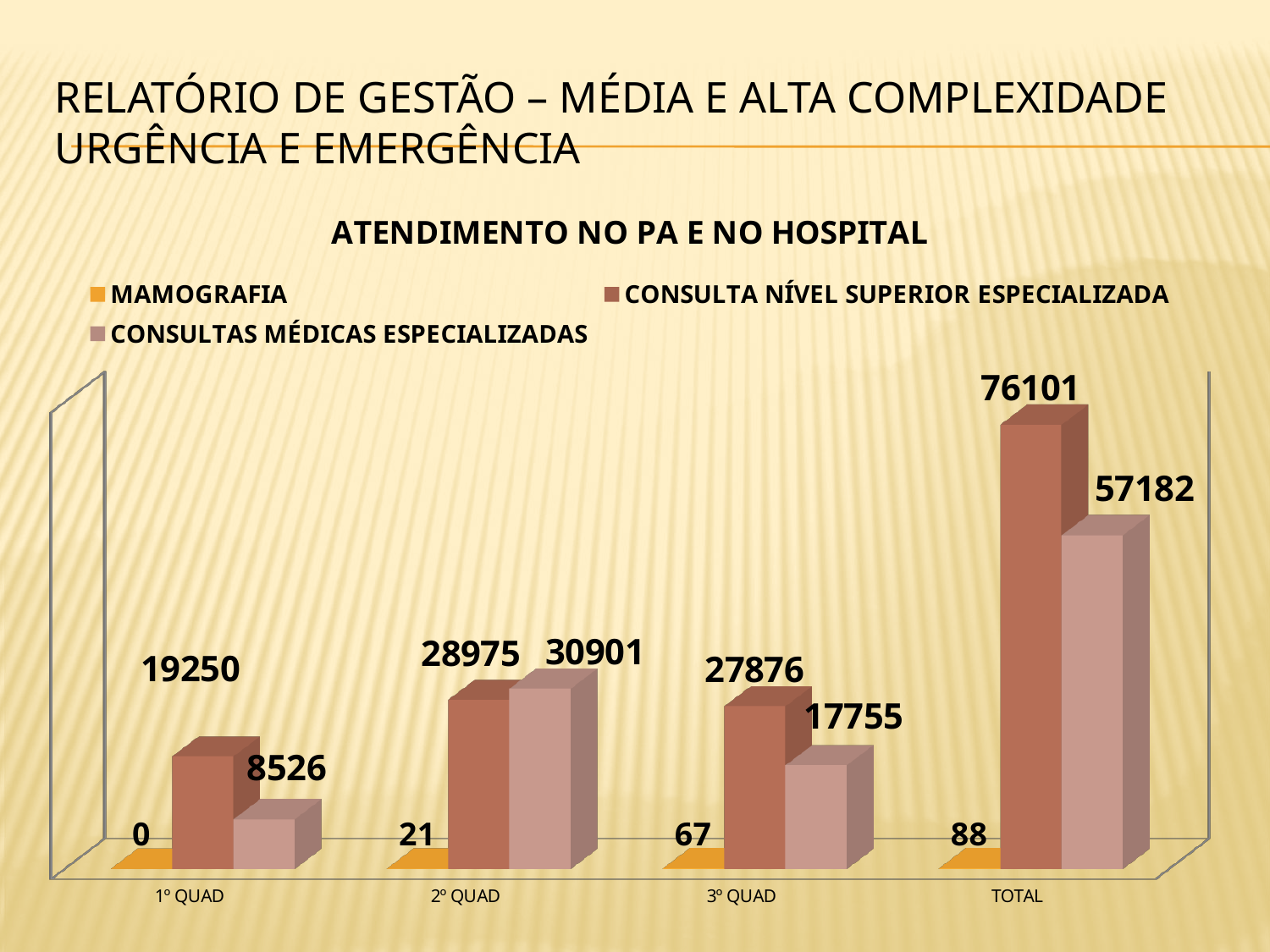
What is the title of the chart? ATENDIMENTO NO PA E NO HOSPITAL Which category has the highest value for CONSULTA NÍVEL SUPERIOR ESPECIALIZADA? TOTAL How many series does the legend list? 3 What is the value of MAMOGRAFIA for 3º QUAD? 67 What is the value of CONSULTAS MÉDICAS ESPECIALIZADAS for 2º QUAD? 30901 In 2º QUAD, which is larger: CONSULTA NÍVEL SUPERIOR ESPECIALIZADA or CONSULTAS MÉDICAS ESPECIALIZADAS? CONSULTAS MÉDICAS ESPECIALIZADAS What is the TOTAL value for CONSULTAS MÉDICAS ESPECIALIZADAS? 57182 What kind of chart is shown on the slide? Bar chart What is the value of CONSULTA NÍVEL SUPERIOR ESPECIALIZADA for 1º QUAD? 19250 How many categories are shown on the x axis? 4 Which category has the lowest value for MAMOGRAFIA? 1º QUAD What is the difference between CONSULTA NÍVEL SUPERIOR ESPECIALIZADA and CONSULTAS MÉDICAS ESPECIALIZADAS in 3º QUAD? 10121